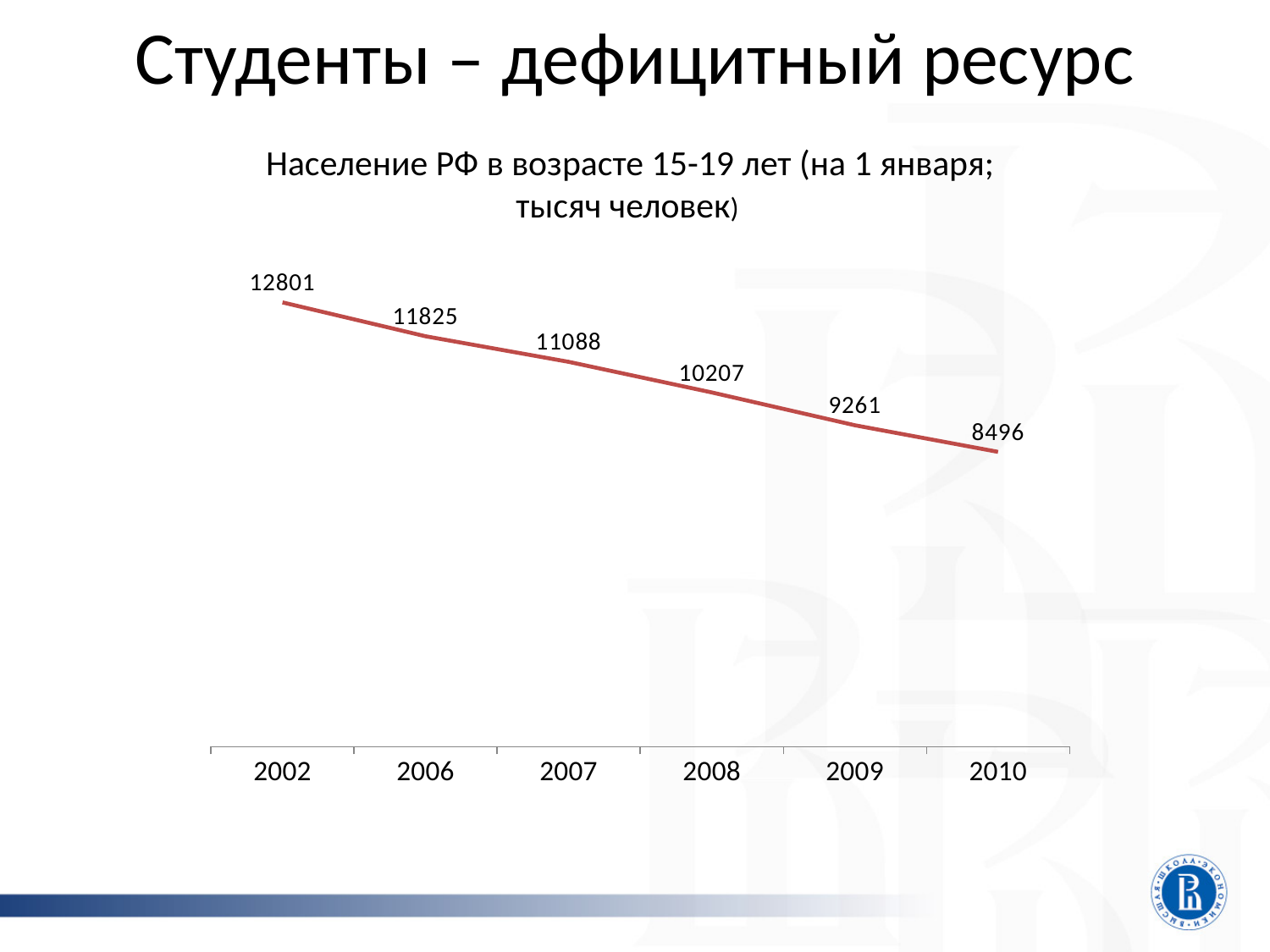
What is the value for 2010? 8496 What is the difference between the values for 2002 and 2010? 4305 What is the title of the chart? Население РФ в возрасте 15-19 лет (на 1 января; тысяч человек) What is the difference between the values for 2008 and 2009? 946 What is the value for 2007? 11088 What is the value for 2002? 12801 Which year has the highest value? 2002 Which is larger, the value for 2006 or the value for 2008? 2006 How many years are plotted on the chart? 6 What kind of chart is this? line chart Which year has the lowest value? 2010 Do the values rise or fall from 2002 to 2010? fall